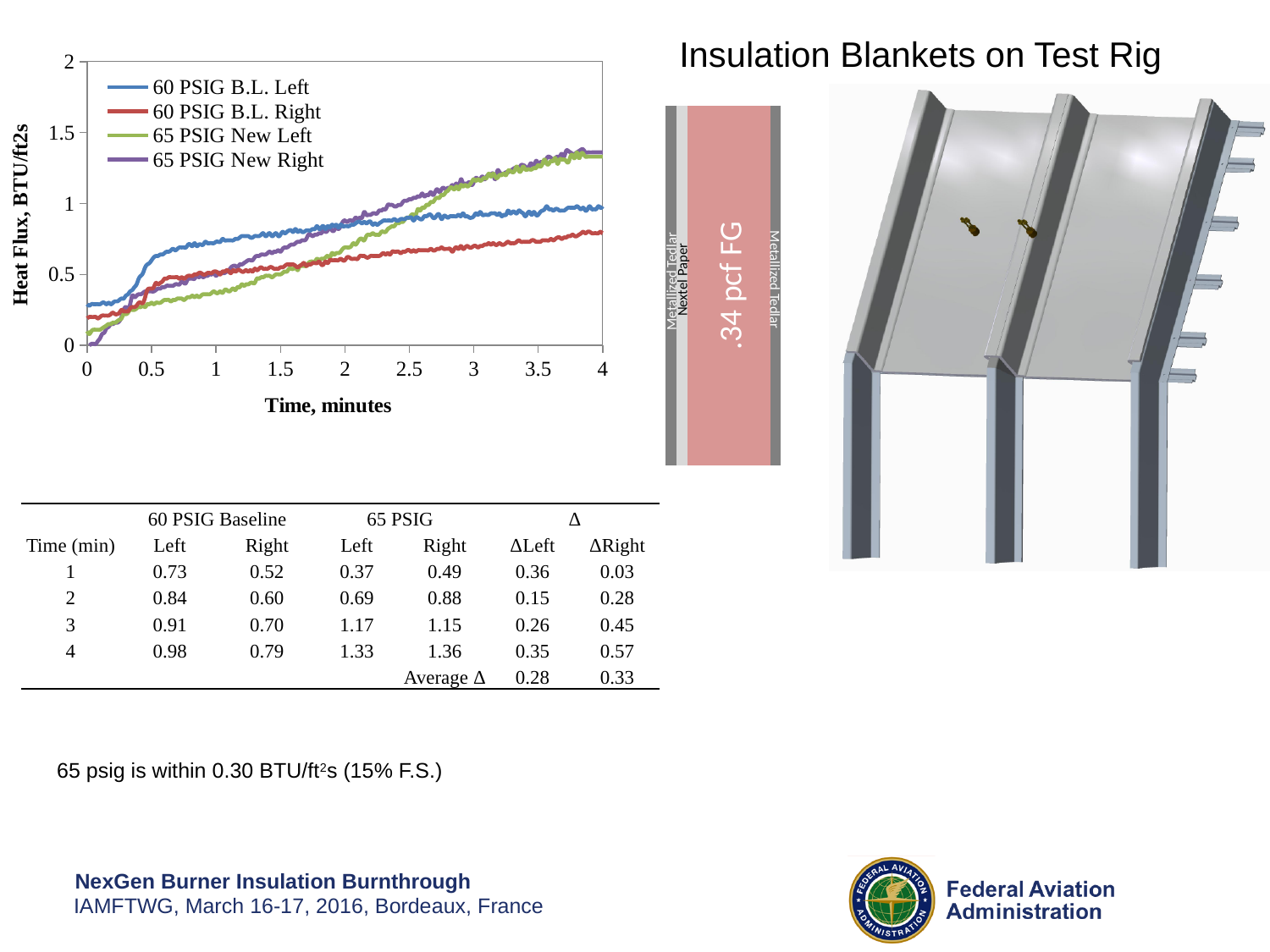
In the heat flux chart, is the value for 65 PSIG New Left at 3 minutes greater or less than 1? greater In the heat flux chart, is the value for 65 PSIG New Left at 1 minute greater or less than 0.5? less In the heat flux chart, which series has the lowest value at 4 minutes? 60 PSIG B.L. Right In the heat flux chart, is the value for 60 PSIG B.L. Left at 1 minute greater or less than 0.5? greater In the heat flux chart, at 4 minutes, which is higher: 65 PSIG New Right or 60 PSIG B.L. Right? 65 PSIG New Right In the heat flux chart, does the 65 PSIG New Right series generally rise or fall over time? rise What is the x-axis title of the heat flux chart? Time, minutes What is the y-axis title of the heat flux chart? Heat Flux, BTU/ft2s What kind of chart is shown on the left of the slide? line chart How many series does the legend of the heat flux chart list? 4